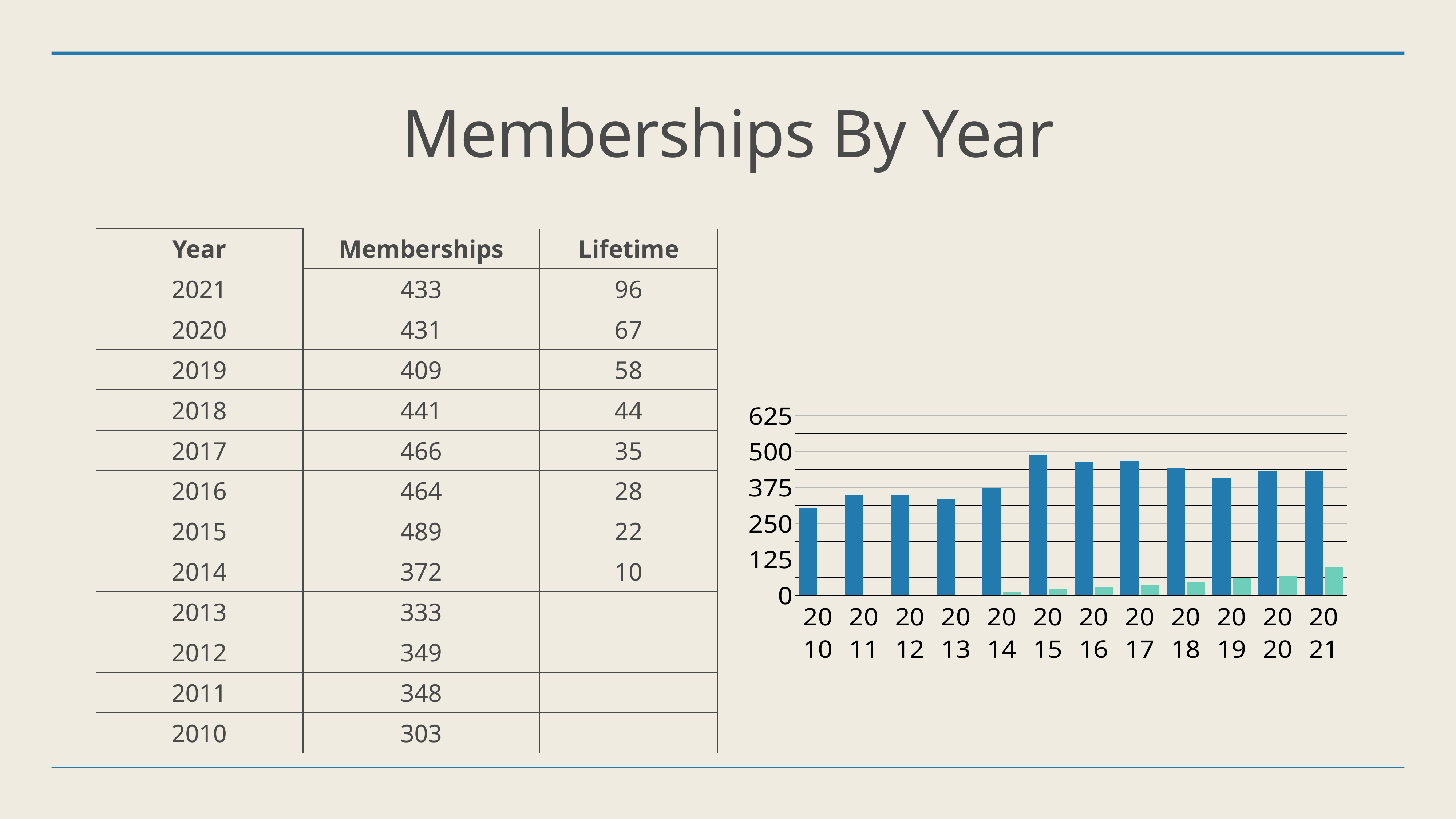
What kind of chart is shown on the slide? bar chart Which year has the shortest blue (Memberships) bar in the chart? 2010 Do the teal (Lifetime) bars rise or fall from 2014 to 2021? rise Is the Memberships value for 2010 greater or less than 375? less Is the Memberships value for 2014 greater or less than 500? less How many years are plotted along the x axis of the chart? 12 Which year has the larger Memberships bar, 2017 or 2019? 2017 Is the Memberships value for 2015 greater or less than 375? greater Which year has the tallest blue (Memberships) bar in the chart? 2015 What is the title of the slide containing the chart? Memberships By Year What is the Memberships value for 2015 as shown in the table? 489